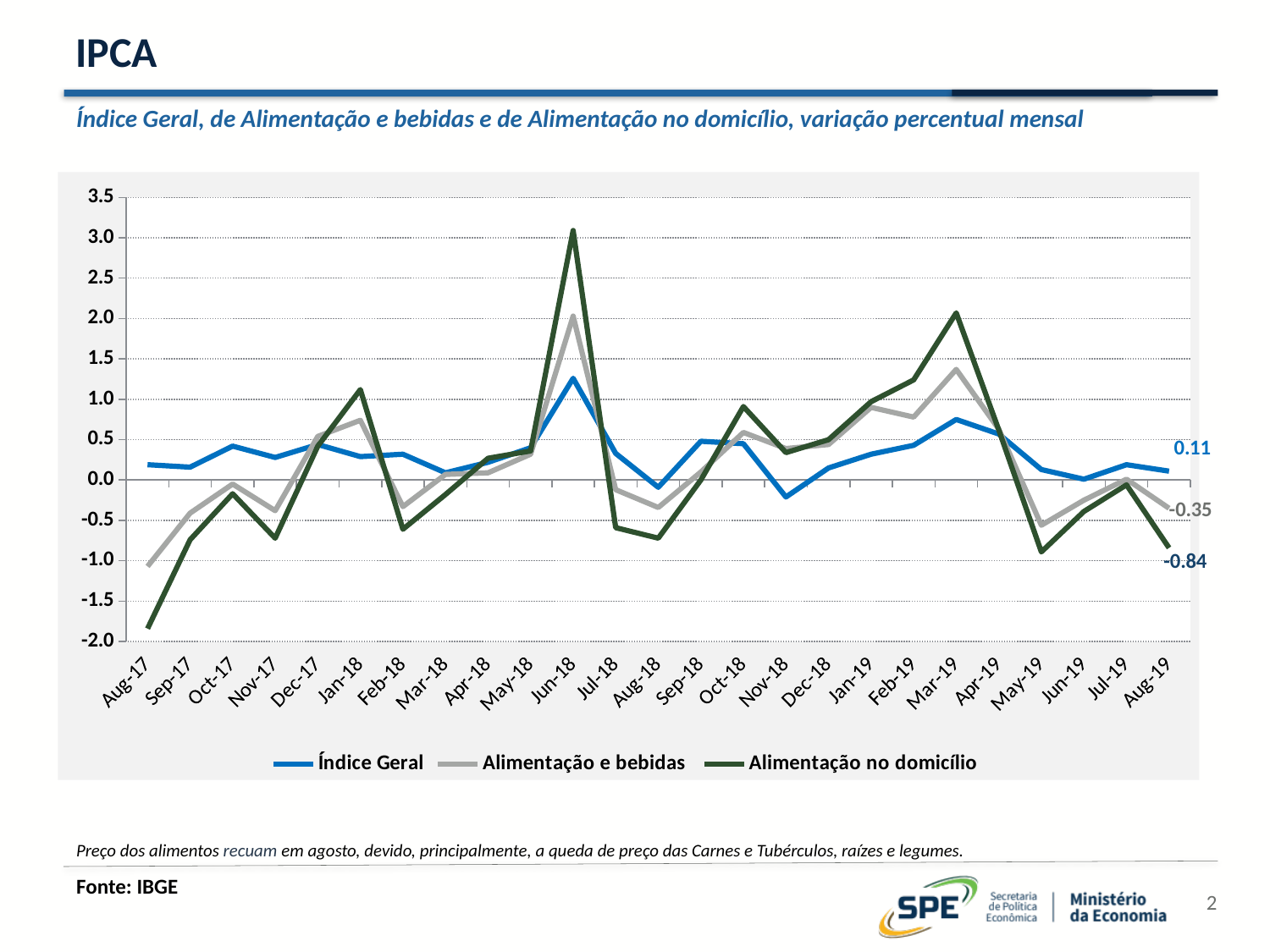
In Aug-19, what is the difference between Índice Geral and Alimentação no domicílio? 0.95 How many months are plotted along the x axis? 25 What is the value of Índice Geral in Aug-19? 0.11 In which month does Alimentação no domicílio reach its highest value? Jun-18 In Aug-19, which is larger, Índice Geral or Alimentação e bebidas? Índice Geral Is the value for Alimentação no domicílio in Jun-18 greater or less than 2.5? greater In which month does Alimentação no domicílio reach its lowest value? Aug-17 How many series does the legend list? 3 Which colour is used for the Índice Geral series? Blue What is the value of Alimentação no domicílio in Aug-19? -0.84 What kind of chart is shown on the slide? Line chart What is the value of Alimentação e bebidas in Aug-19? -0.35